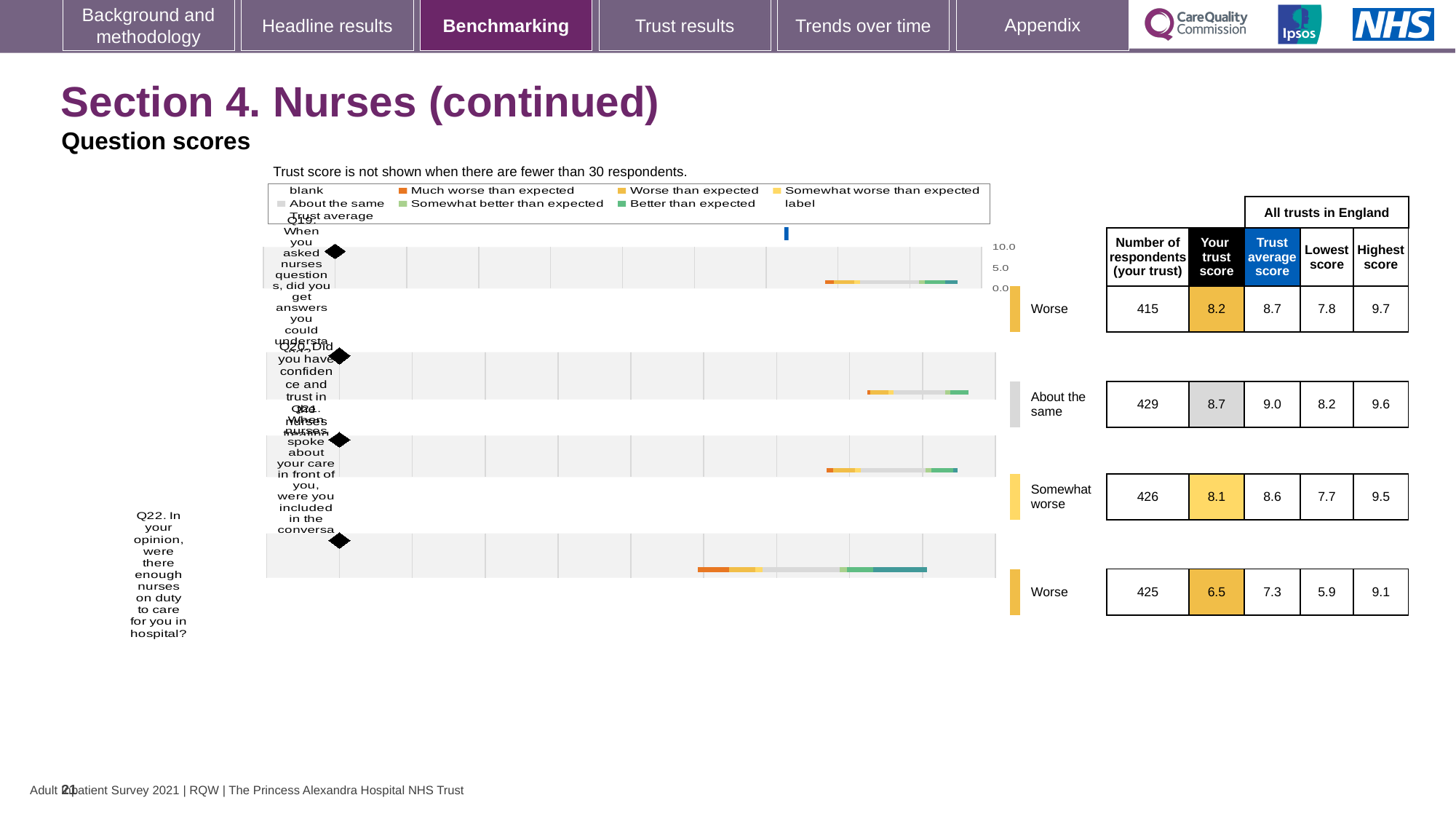
Which question has the lowest 'Your trust score'? Q22 What kind of chart is used to show the question scores? bar chart What is the difference between the trust average score and your trust score for Q22? 0.8 How many questions are plotted on the chart? 4 Which has the higher trust score, Q19 or Q20? Q20 What is the lowest score across all trusts in England for Q22? 5.9 Which question has the highest number of respondents? Q20 What is the maximum value shown on the chart's score axis? 10.0 What benchmark category is shown for Q21 (were you included in the conversation)? Somewhat worse What is the trust score for Q22 (were there enough nurses on duty to care for you in hospital)? 6.5 What is the highest score across all trusts in England for Q19? 9.7 How many respondents answered Q20 (confidence and trust in the nurses)? 429